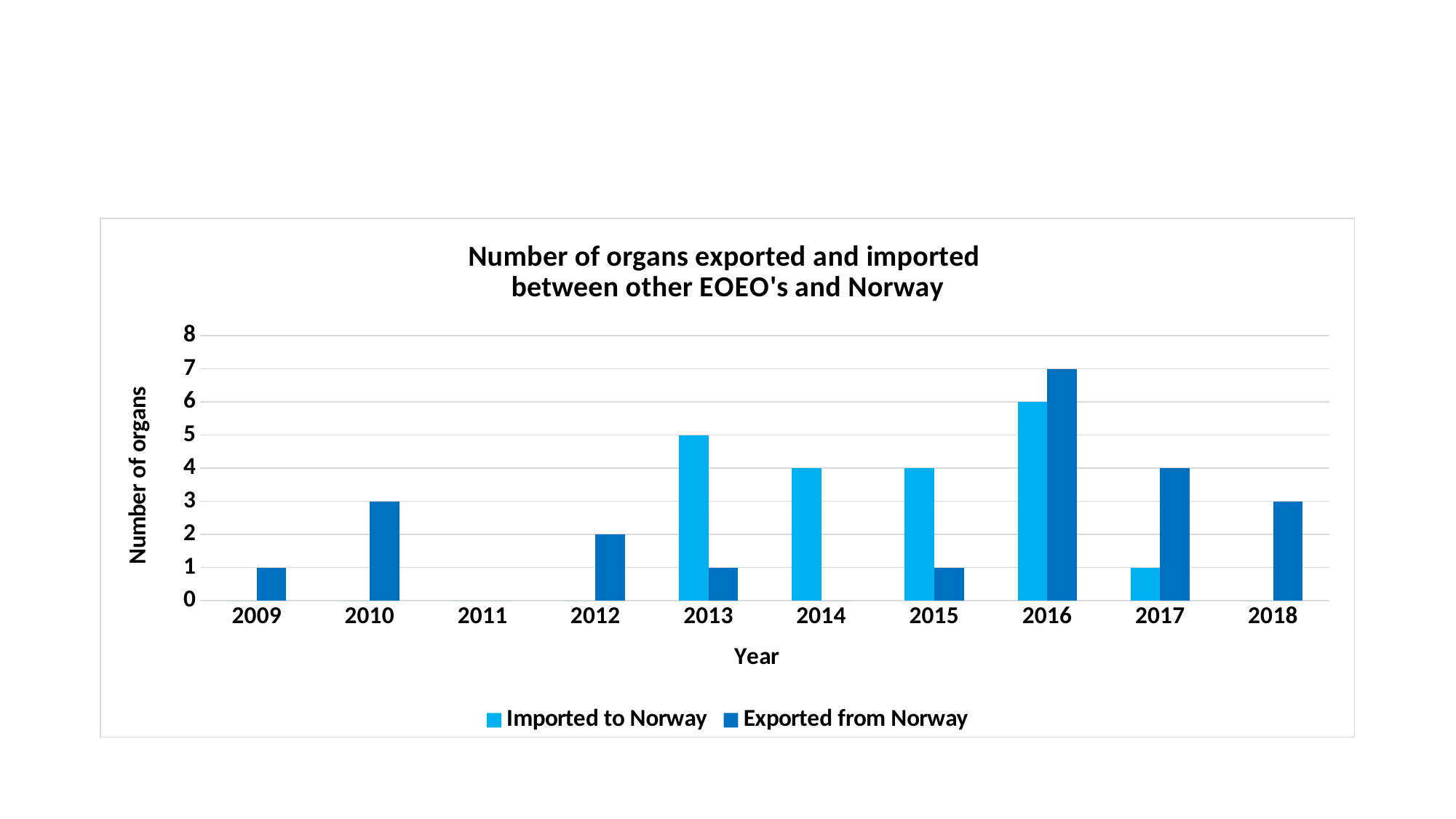
What is the difference between Exported from Norway and Imported to Norway in 2017? 3 What is the title of the chart? Number of organs exported and imported between other EOEO's and Norway Is the value for Imported to Norway in 2016 greater or less than 4? greater How many years are shown on the x axis? 10 How many series does the legend list? 2 Which year has the highest value for Exported from Norway? 2016 In 2013, which is larger: Imported to Norway or Exported from Norway? Imported to Norway What is the value for Exported from Norway in 2010? 3 What is the value for Exported from Norway in 2016? 7 What type of chart is shown on the slide? bar chart Which year has the highest value for Imported to Norway? 2016 What is the value for Imported to Norway in 2013? 5